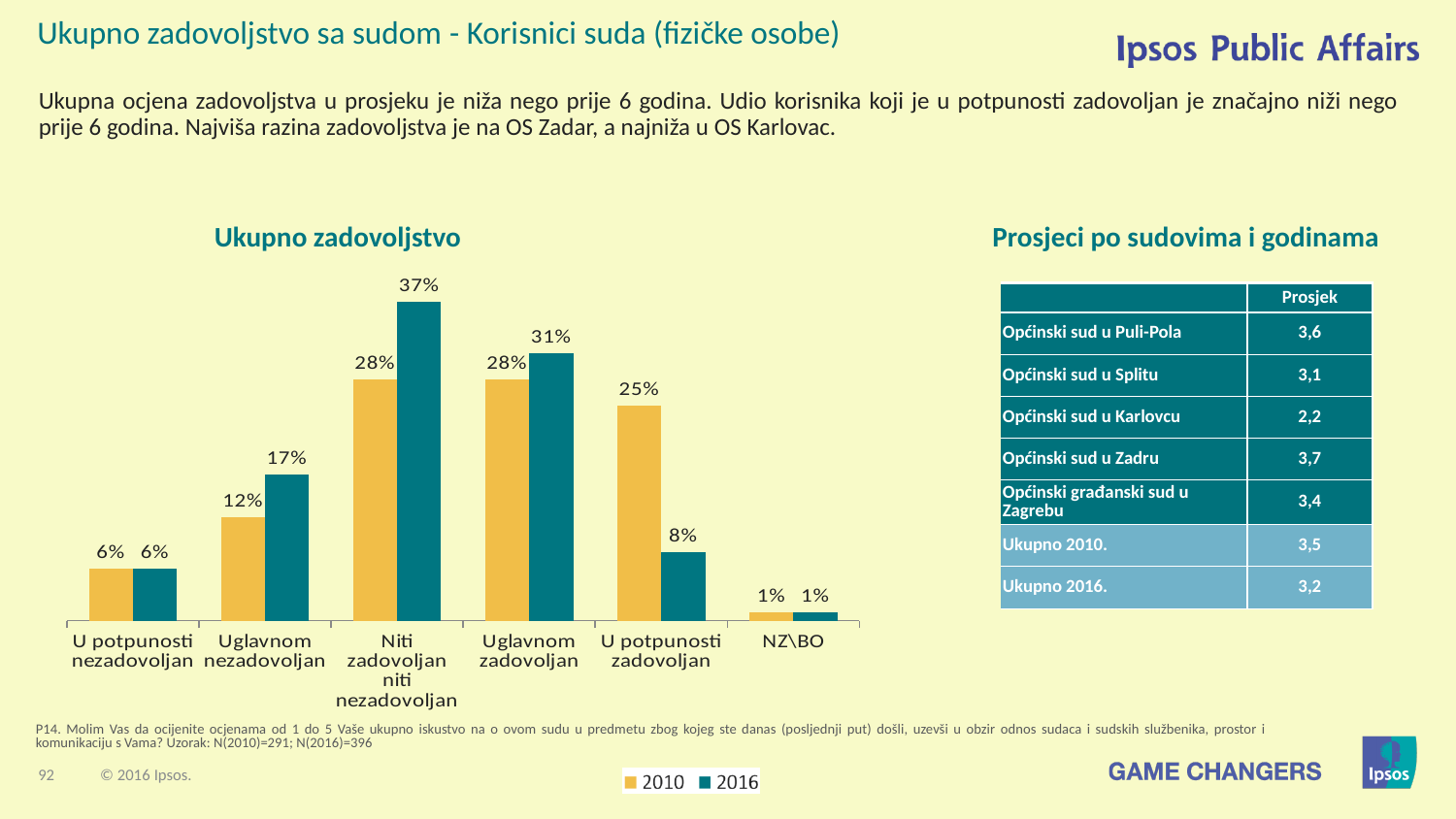
How many series does the legend of the 'Ukupno zadovoljstvo' chart list? 2 Which category has the lowest 2010 value in the 'Ukupno zadovoljstvo' chart? NZ\BO What is the difference between the 2016 and 2010 values for 'Niti zadovoljan niti nezadovoljan' in the 'Ukupno zadovoljstvo' chart? 9% What is the 2010 value for 'U potpunosti zadovoljan' in the 'Ukupno zadovoljstvo' chart? 25% What is the 2016 value for 'Uglavnom nezadovoljan' in the 'Ukupno zadovoljstvo' chart? 17% In the 'Ukupno zadovoljstvo' chart, is the 2016 value for 'Uglavnom zadovoljan' larger or smaller than the 2010 value? larger How many categories are shown on the x axis of the 'Ukupno zadovoljstvo' chart? 6 What is the difference between the 2010 and 2016 values for 'U potpunosti zadovoljan' in the 'Ukupno zadovoljstvo' chart? 17% Which colour represents the 2016 series in the 'Ukupno zadovoljstvo' chart? teal What is the 2016 value for 'Niti zadovoljan niti nezadovoljan' in the 'Ukupno zadovoljstvo' chart? 37% Which category has the highest 2016 value in the 'Ukupno zadovoljstvo' chart? Niti zadovoljan niti nezadovoljan What type of chart is 'Ukupno zadovoljstvo'? bar chart